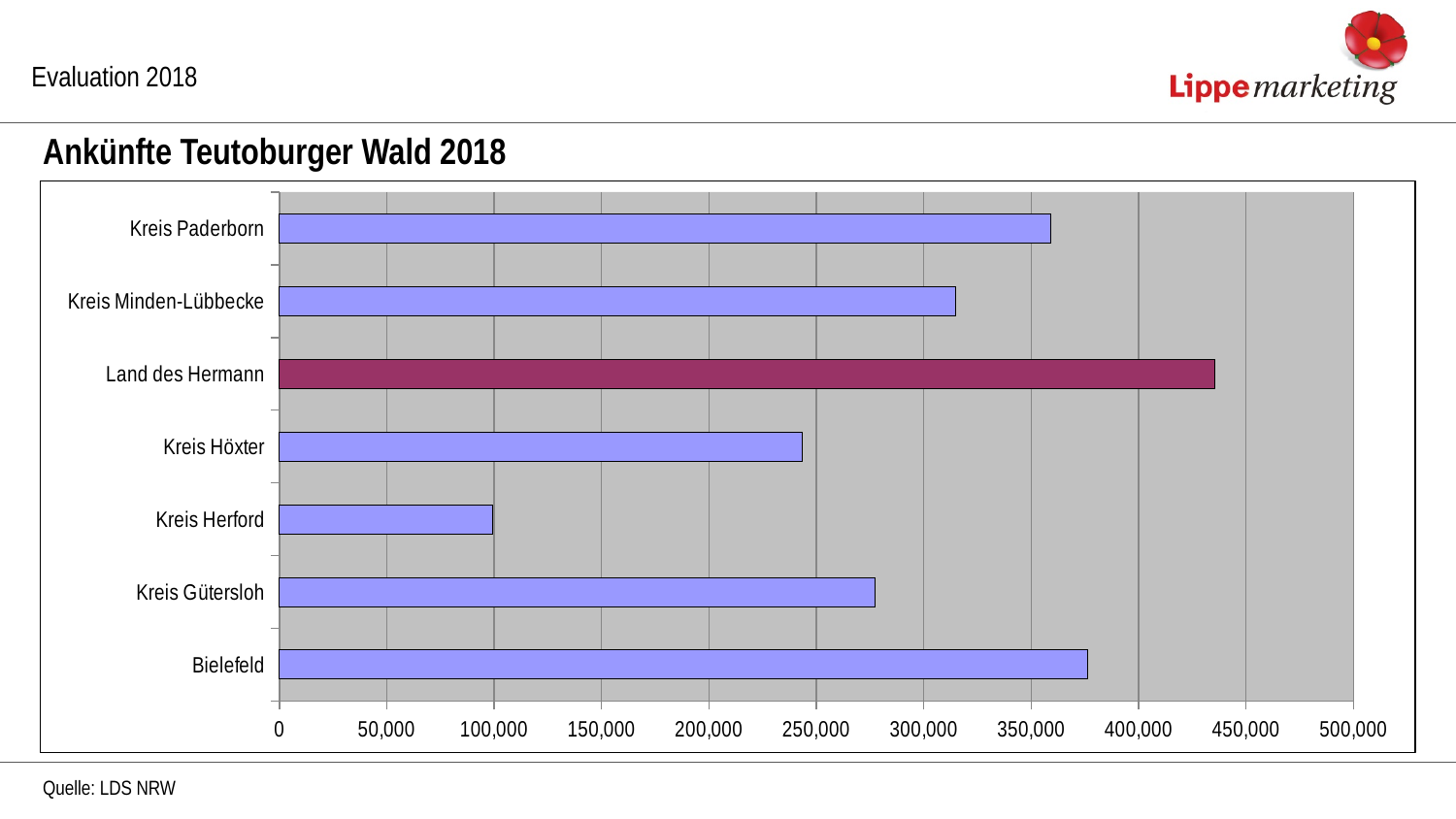
How many categories are plotted in the chart? 7 Which category has the highest value? Land des Hermann Is the value for Kreis Minden-Lübbecke greater or less than 300,000? greater Which is larger, the value for Kreis Minden-Lübbecke or the value for Kreis Gütersloh? Kreis Minden-Lübbecke Which bar is shown in a different colour from the others? Land des Hermann Which category has the lowest value? Kreis Herford Is the value for Bielefeld greater or less than 350,000? greater What kind of chart is shown on the slide? bar chart Is the value for Kreis Höxter greater or less than 250,000? less What is the title of the chart? Ankünfte Teutoburger Wald 2018